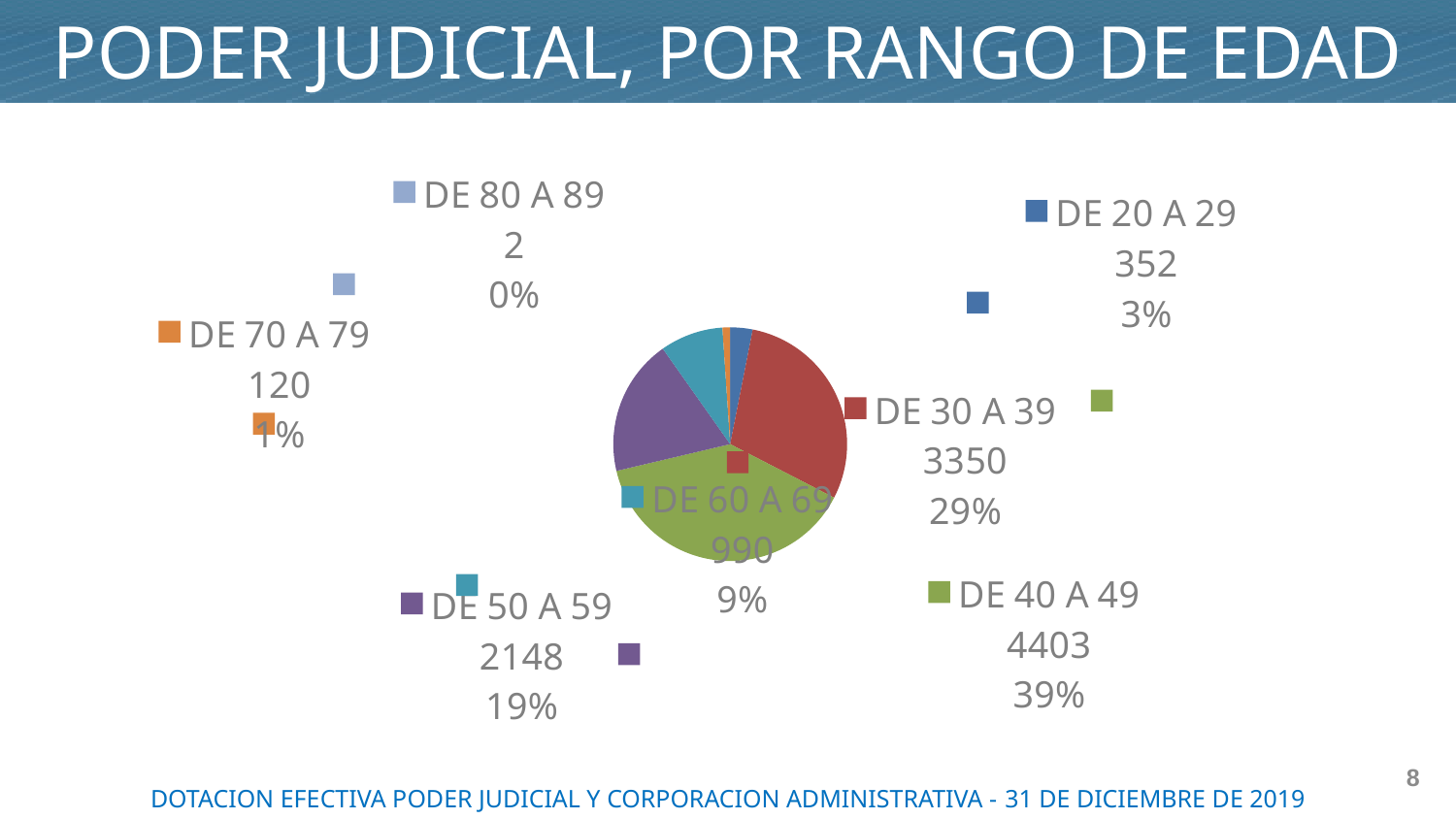
What is the title of the chart on the slide? PODER JUDICIAL, POR RANGO DE EDAD What percentage share does DE 20 A 29 have? 3% Which is larger, the value for DE 50 A 59 or the value for DE 60 A 69? DE 50 A 59 What is the difference between the values for DE 40 A 49 and DE 30 A 39? 1053 How many age-range categories does the pie chart show? 7 What is the value for DE 30 A 39? 3350 What percentage share does DE 50 A 59 have? 19% What is the value for DE 40 A 49? 4403 What is the value for DE 60 A 69? 990 Which age range has the largest value? DE 40 A 49 What kind of chart is shown on the slide? pie chart Which age range has the smallest value? DE 80 A 89